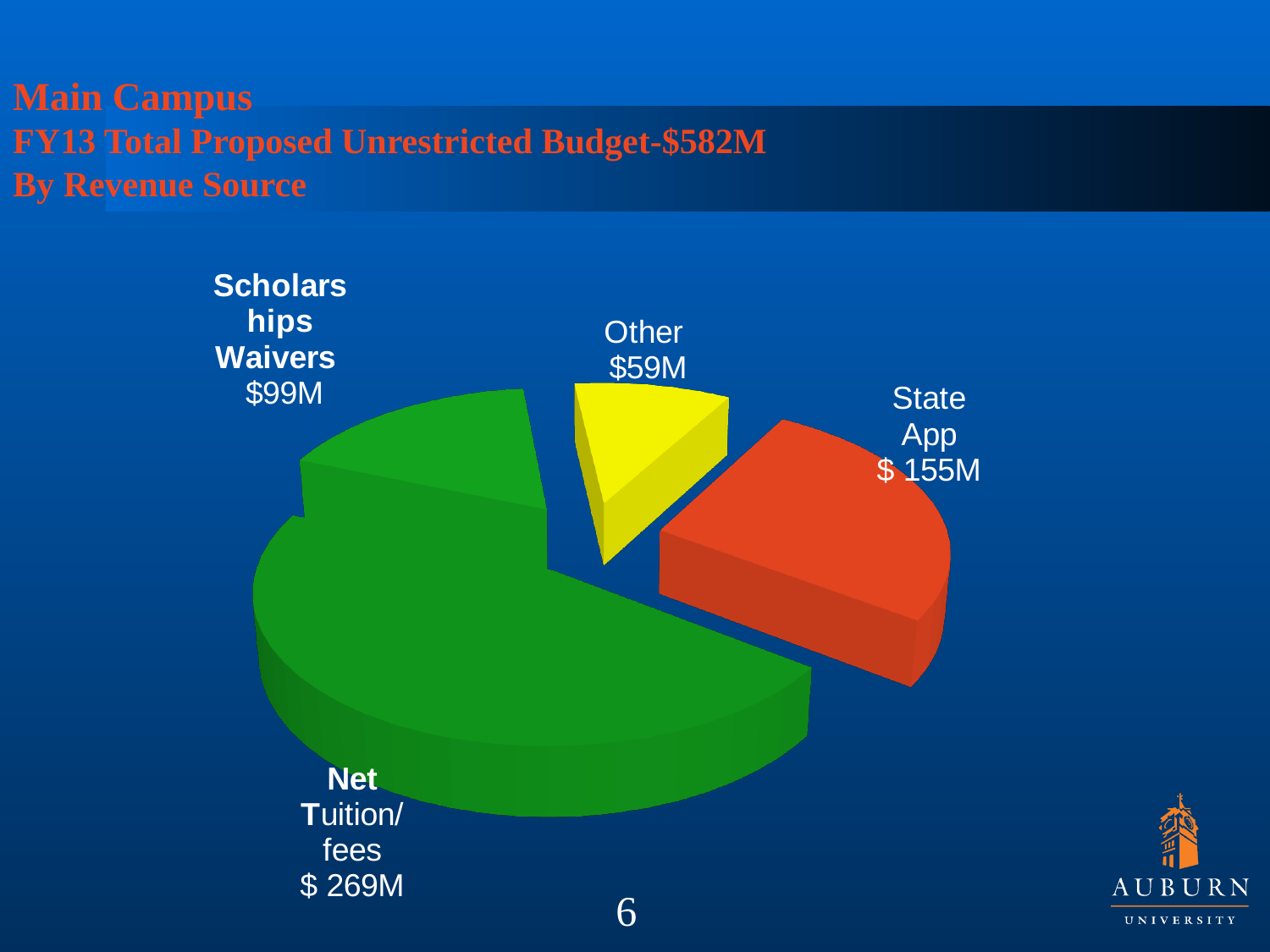
Which is larger, State App or Scholarships Waivers? State App What is the difference between Scholarships Waivers and Other? $40M What is the value for Scholarships Waivers? $99M Which revenue source has the largest value? Net Tuition/fees What kind of chart is shown on the slide? pie chart What total budget amount is stated in the slide title? $582M Which revenue source has the smallest value? Other What is the value for Net Tuition/fees? $ 269M What is the difference between Net Tuition/fees and State App? $114M What is the value for State App? $ 155M How many revenue sources are shown in the pie chart? 4 What is the value for Other? $59M